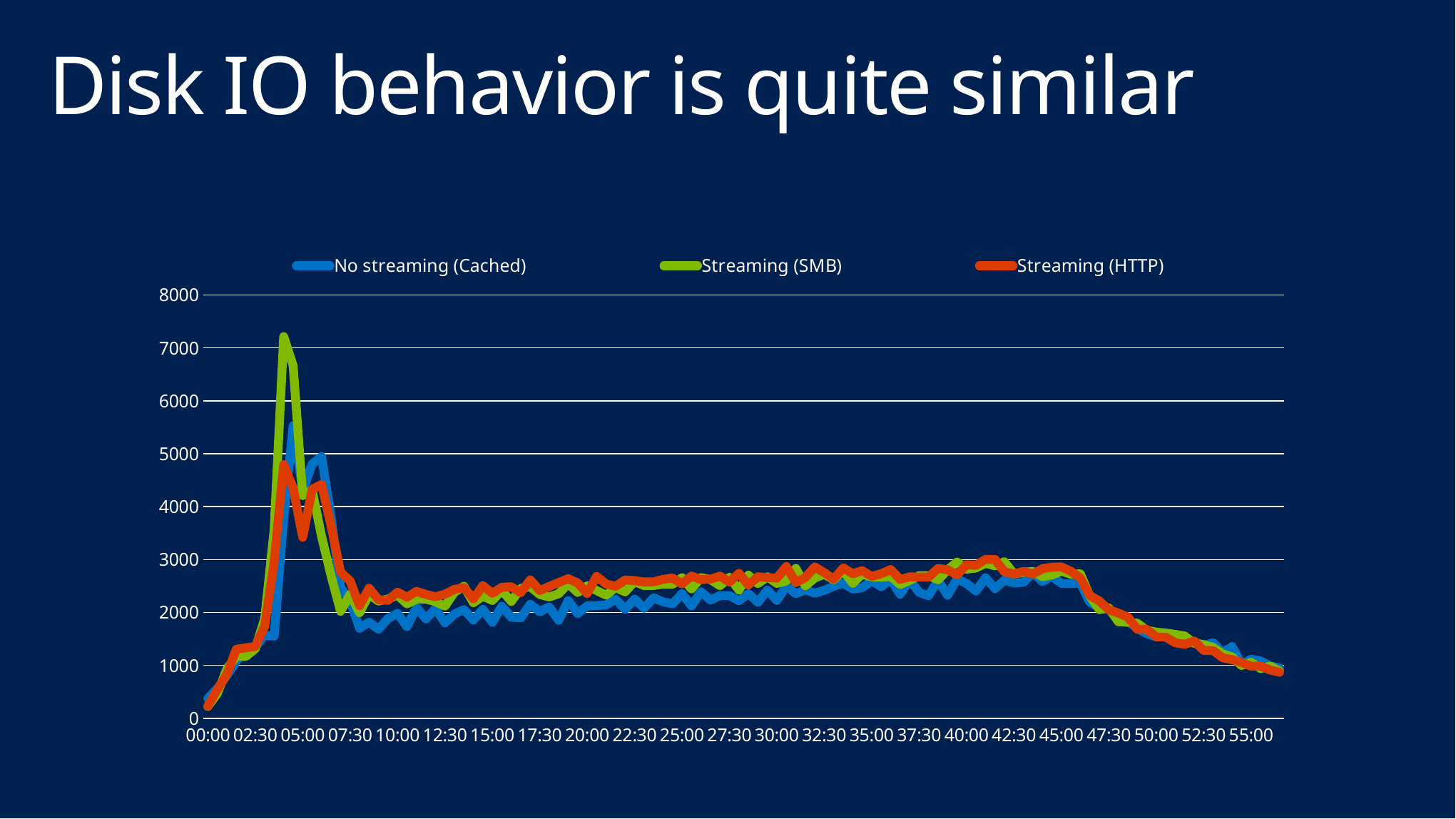
What kind of chart is shown on the slide? line chart Is the peak value of the Streaming (HTTP) series greater or less than 5000? less Is the peak value of the No streaming (Cached) series greater or less than 6000? less Is the peak value of the Streaming (SMB) series greater or less than 7000? greater How many series does the legend list? 3 What is the title of the slide containing the chart? Disk IO behavior is quite similar Which series is drawn in green in the chart? Streaming (SMB) Which series reaches the highest peak value in the chart? Streaming (SMB) Do the values of the series rise or fall between 45:00 and 55:00? fall What is the highest value shown on the vertical axis? 8000 Which series has the higher peak, Streaming (SMB) or Streaming (HTTP)? Streaming (SMB)